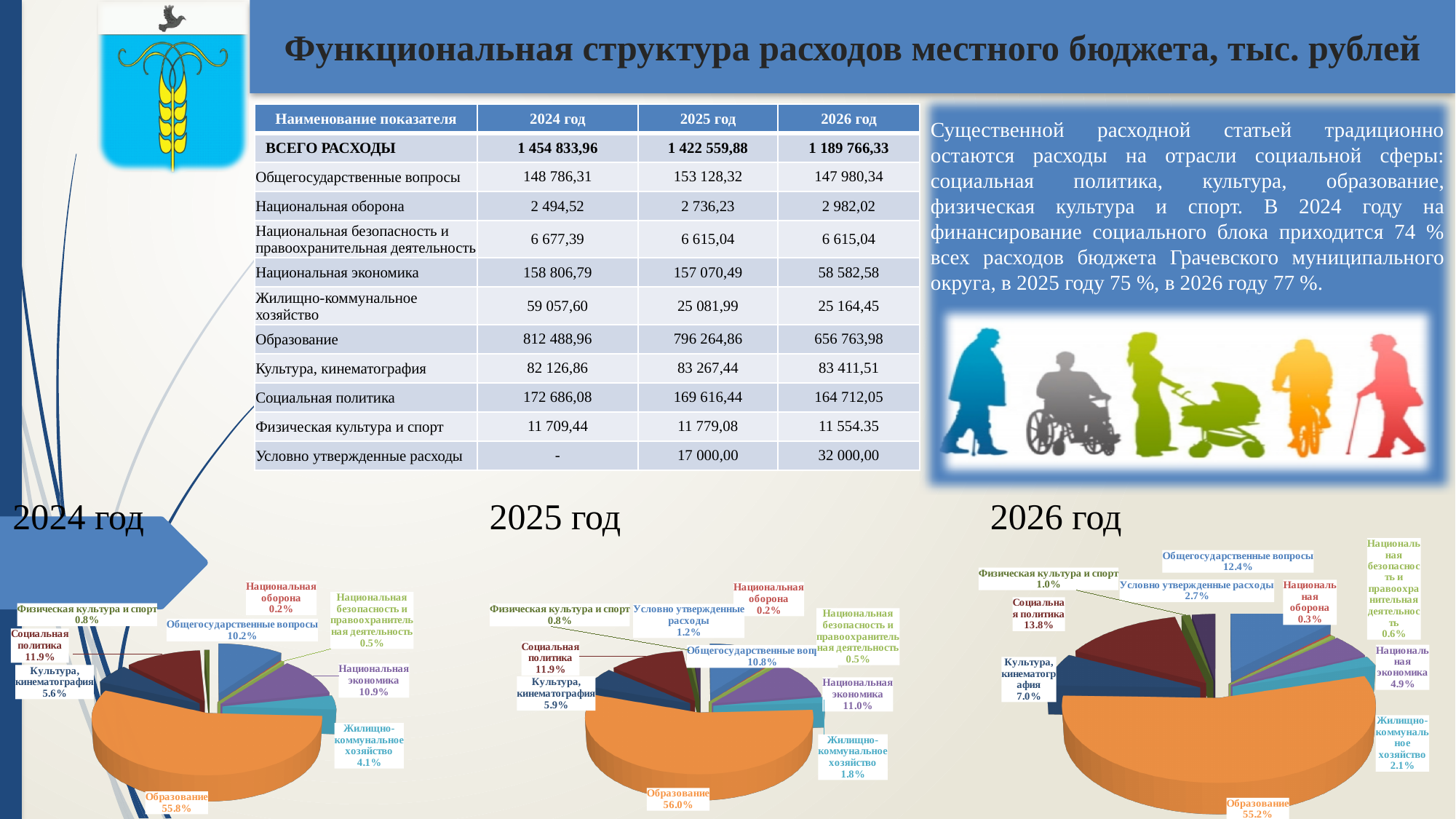
What type of chart is used for 2025 год? Pie chart In the 2026 год pie chart, what share does Социальная политика have? 13.8% In the 2024 год pie chart, what is the difference between the shares of Социальная политика and Общегосударственные вопросы? 1.7% In the 2024 год pie chart, which category has the largest share? Образование In the 2026 год pie chart, which is larger: Культура, кинематография or Национальная экономика? Культура, кинематография How many slices does the 2024 год pie chart have? 9 In the 2026 год pie chart, what share does Условно утвержденные расходы have? 2.7% In the 2026 год pie chart, what is the difference between the shares of Образование and Социальная политика? 41.4% In the 2025 год pie chart, which category has the smallest share? Национальная оборона How many slices does the 2025 год pie chart have? 10 In the 2025 год pie chart, what share does Национальная экономика have? 11.0%